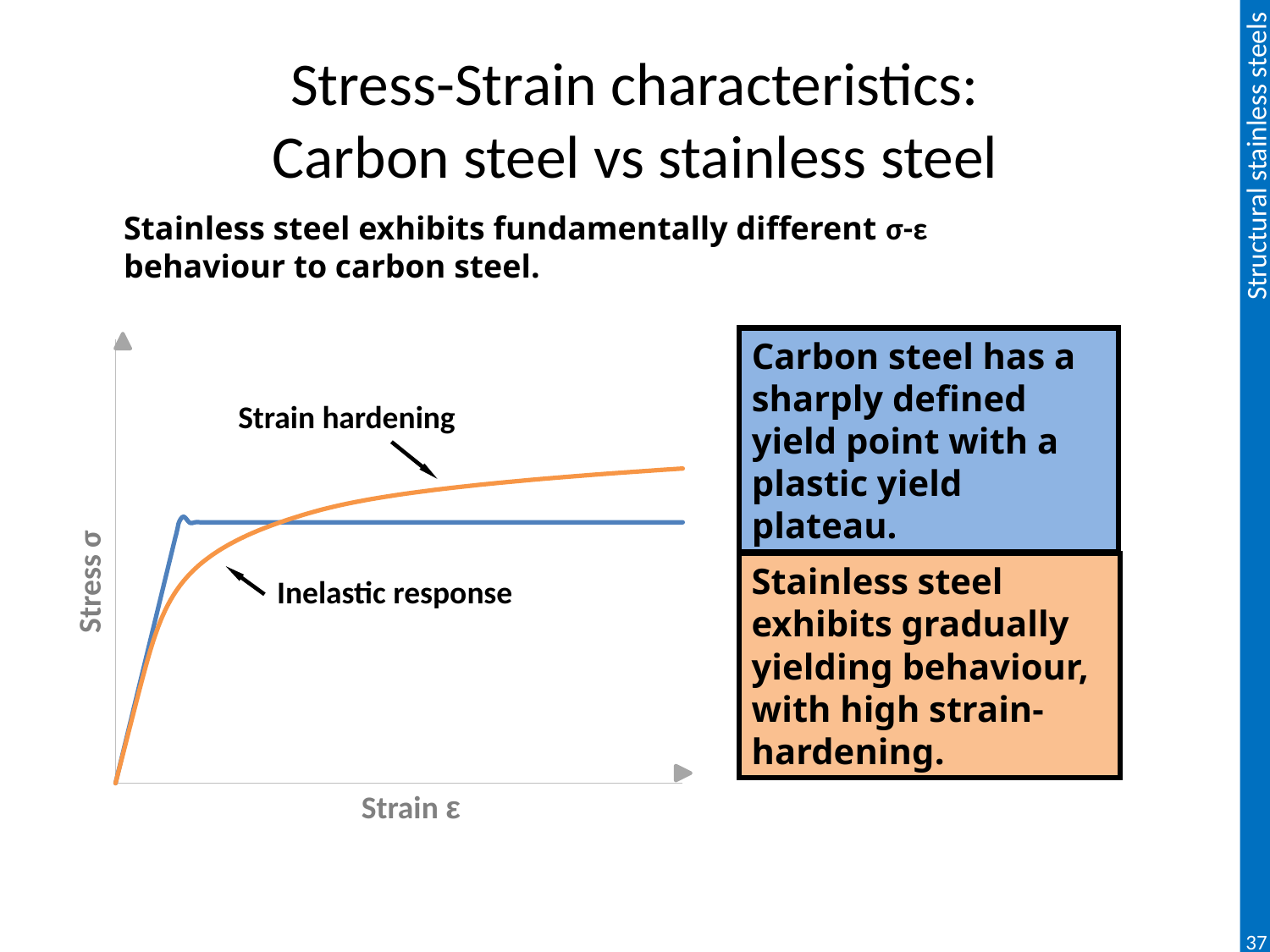
Which curve does the 'Strain hardening' arrow point to, the blue or the orange one? the orange one What kind of chart is shown on the slide? line chart How many curves are plotted on the stress-strain chart? 2 Which curve shows a sharp peak followed by a plateau, the blue or the orange one? the blue one Near the start of the chart (at small strain), which curve rises more steeply, the blue one or the orange one? the blue one After its initial peak, does the blue curve rise, fall or stay flat as strain increases? stay flat Does the orange curve keep rising or level off as strain increases? keep rising What is the label on the horizontal axis of the chart? Strain ε What is the label on the vertical axis of the chart? Stress σ